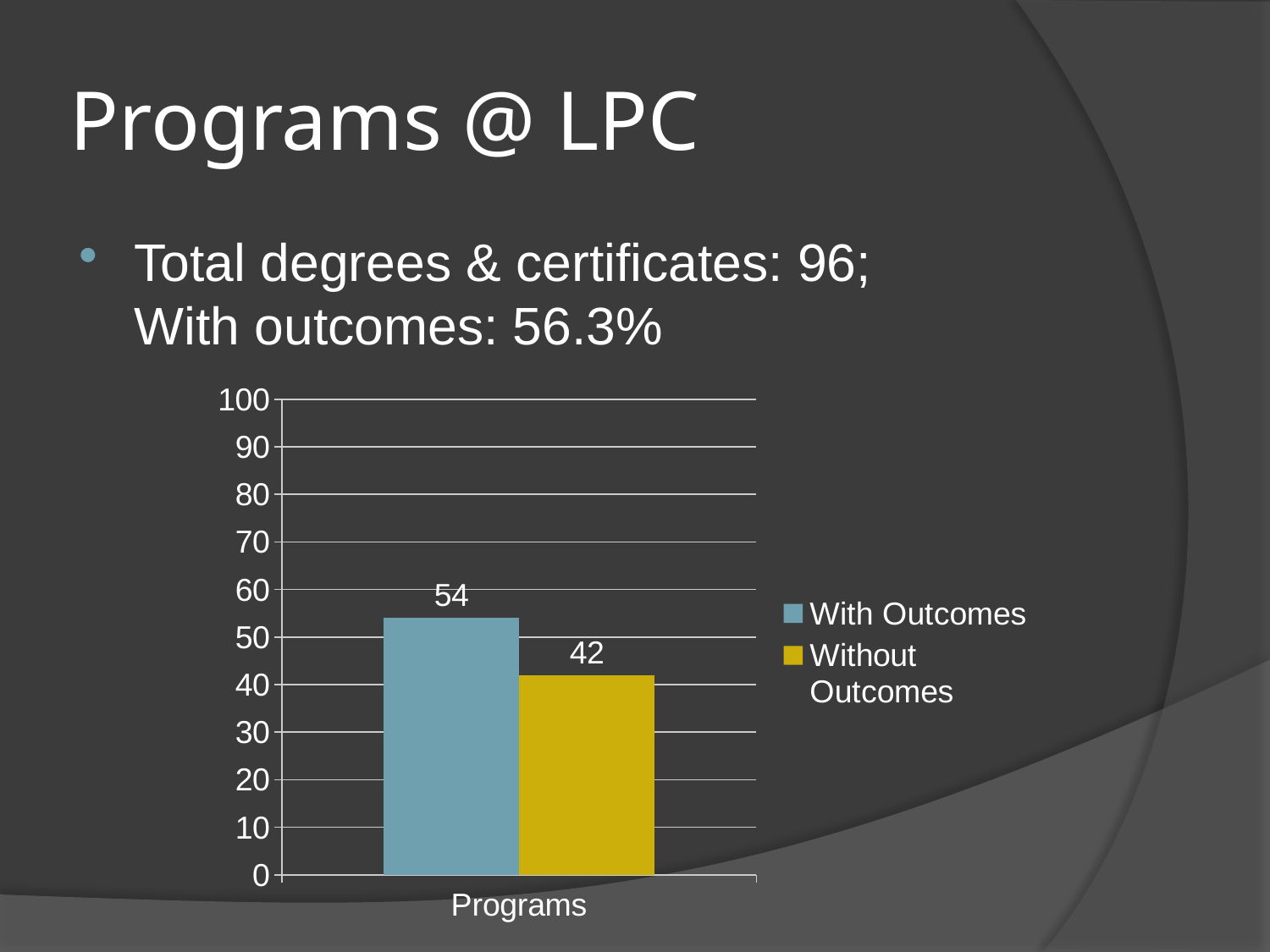
What is the value for With Outcomes in the Programs chart? 54 What is the sum of the With Outcomes and Without Outcomes values? 96 Is the value for With Outcomes greater or less than 50? greater Which series has the lowest value in the chart? Without Outcomes What is the difference between the With Outcomes and Without Outcomes values? 12 How many series does the legend list? 2 What kind of chart is shown on the slide? bar chart What is the value for Without Outcomes in the Programs chart? 42 What is the maximum value shown on the y axis of the chart? 100 What is the category label on the x axis of the chart? Programs Is the value for Without Outcomes greater or less than 50? less Which series has the higher value, With Outcomes or Without Outcomes? With Outcomes